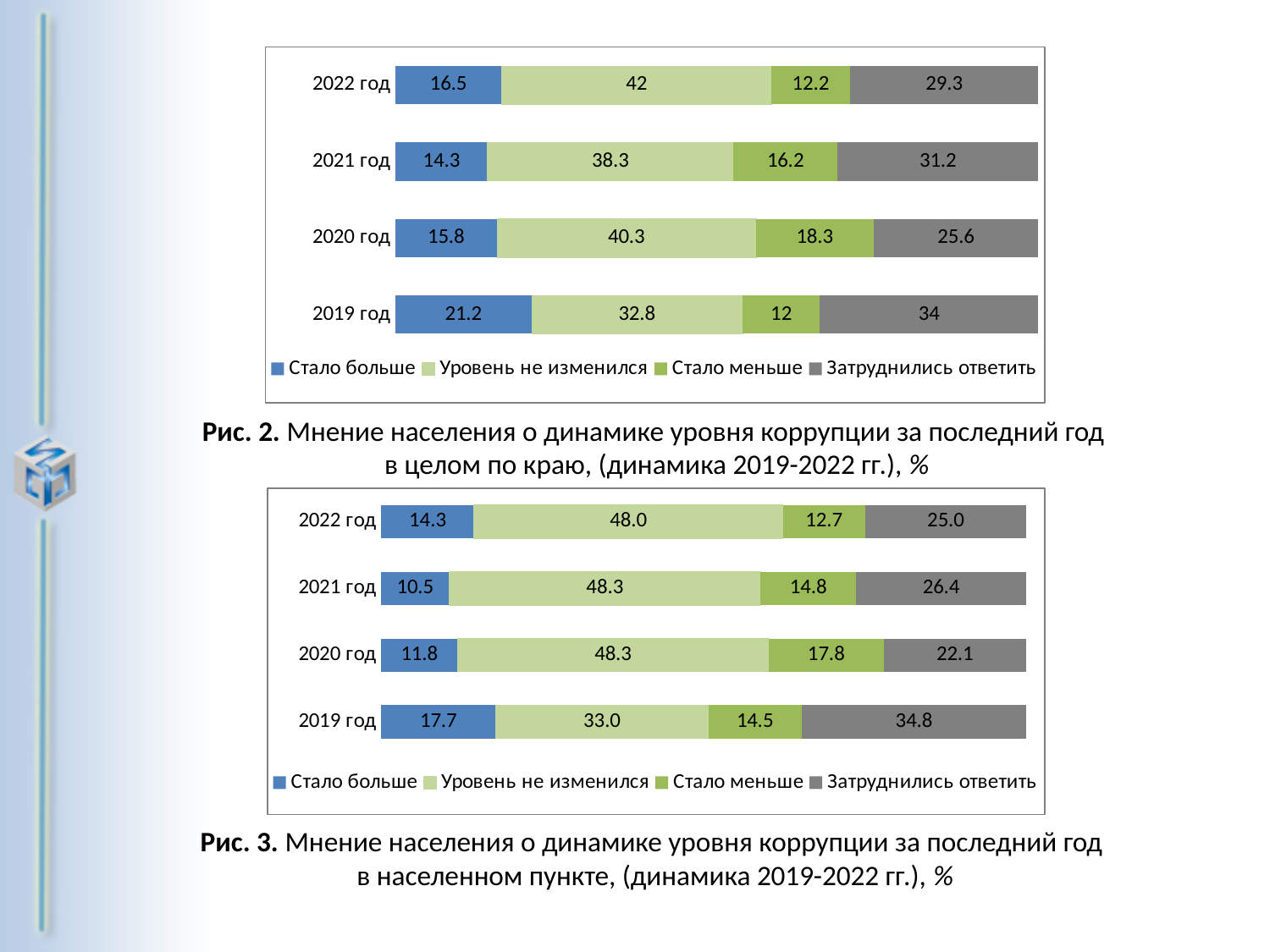
In the top chart (Рис. 2), what is the total of the stacked bar for 2020 год? 100 In the top chart (Рис. 2), what is the difference between the "Уровень не изменился" values for 2022 год and 2019 год? 9.2 In the top chart (Рис. 2), what is the value for "Стало больше" in 2019 год? 21.2 What kind of chart is the top chart (Рис. 2)? Stacked bar chart In the bottom chart (Рис. 3), what is the difference between the "Затруднились ответить" values for 2019 год and 2020 год? 12.7 In the bottom chart (Рис. 3), which year has the highest value for "Затруднились ответить"? 2019 год In the top chart (Рис. 2), which year has the lowest value for "Уровень не изменился"? 2019 год In the top chart (Рис. 2), what is the value for "Затруднились ответить" in 2021 год? 31.2 In the top chart (Рис. 2), which year has the highest value for "Стало меньше"? 2020 год How many series does the legend of the bottom chart (Рис. 3) list? 4 In the bottom chart (Рис. 3), is the "Стало меньше" value larger in 2020 год or in 2022 год? 2020 год In the bottom chart (Рис. 3), what is the value for "Стало больше" in 2021 год? 10.5